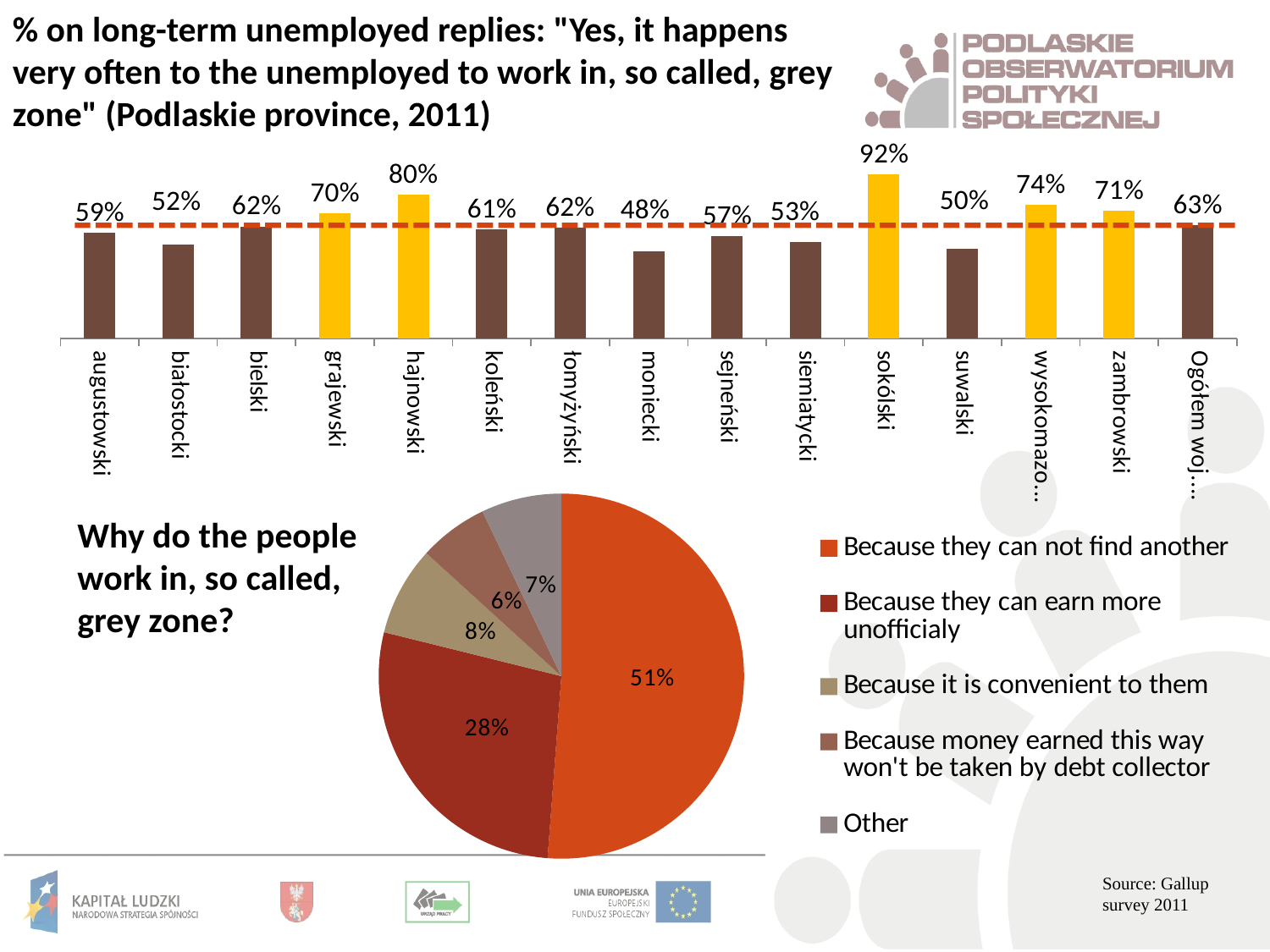
In the pie chart, which reason has the smallest share? Because money earned this way won't be taken by debt collector In the pie chart, what share is given to "Because it is convenient to them"? 8% How many entries does the legend of the pie chart list? 5 In the top bar chart, which county has the highest value? sokólski In the top bar chart, what is the value for moniecki? 48% In the pie chart, what share is given to "Because they can not find another"? 51% In the top bar chart, which is larger, the value for grajewski or the value for zambrowski? zambrowski What kind of chart is the top chart on the slide? bar chart In the top bar chart, what is the value for sokólski? 92% In the top bar chart, what is the difference between the values for hajnowski and suwalski? 30% In the top bar chart, which county has the lowest value? moniecki How many counties/categories are shown in the top bar chart? 15